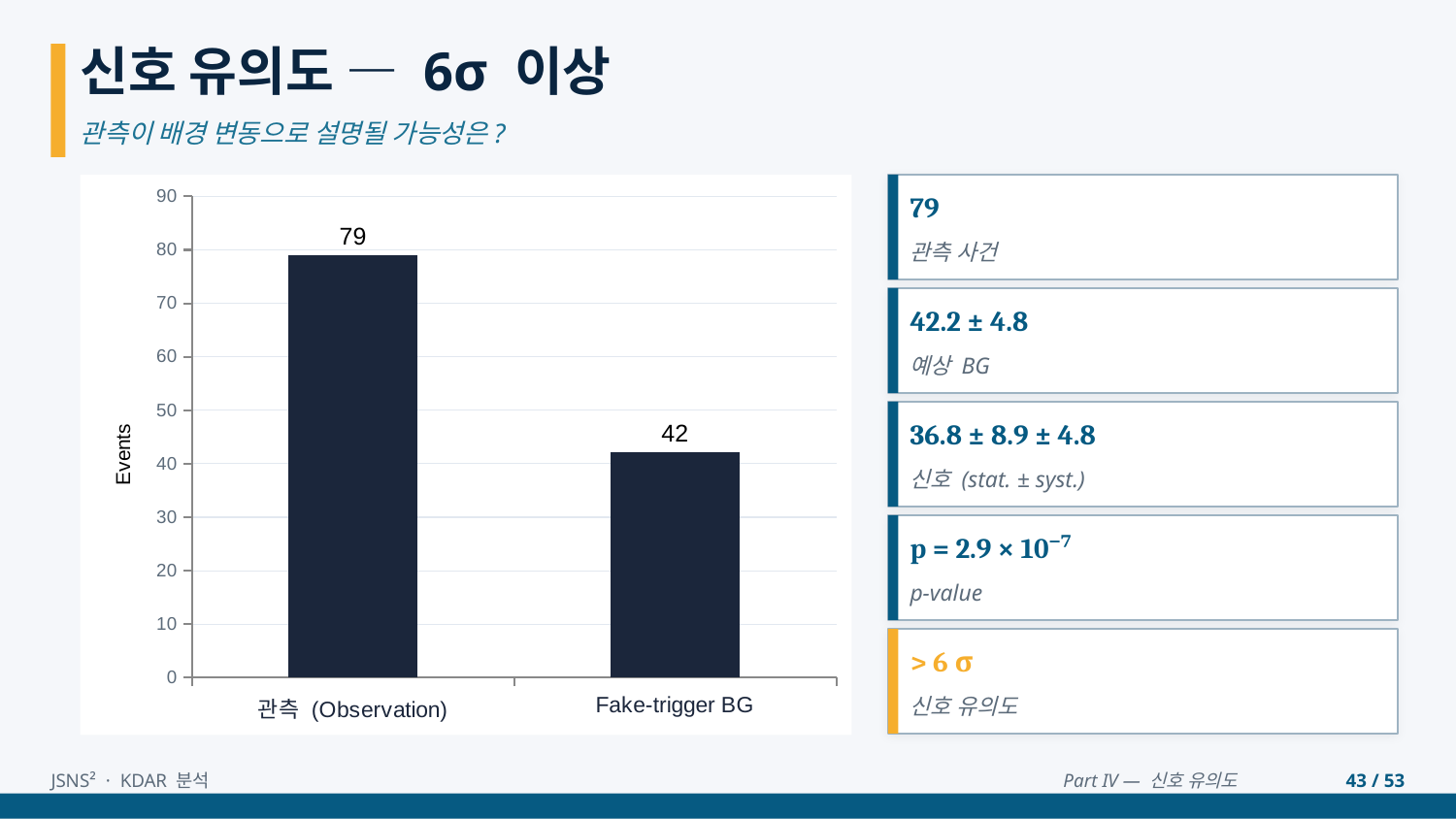
What is the difference between the 관측 (Observation) value and the Fake-trigger BG value? 37 What is the maximum value shown on the y axis? 90 Which is larger, the value for 관측 (Observation) or the value for Fake-trigger BG? 관측 (Observation) What is the value for 관측 (Observation)? 79 Which category has the highest value? 관측 (Observation) What is the value for Fake-trigger BG? 42 Is the value for Fake-trigger BG greater or less than 50? less What is the label of the y axis? Events Which category has the lowest value? Fake-trigger BG How many categories are shown on the x axis? 2 Is the value for 관측 (Observation) greater or less than 70? greater What kind of chart is shown on the slide? bar chart